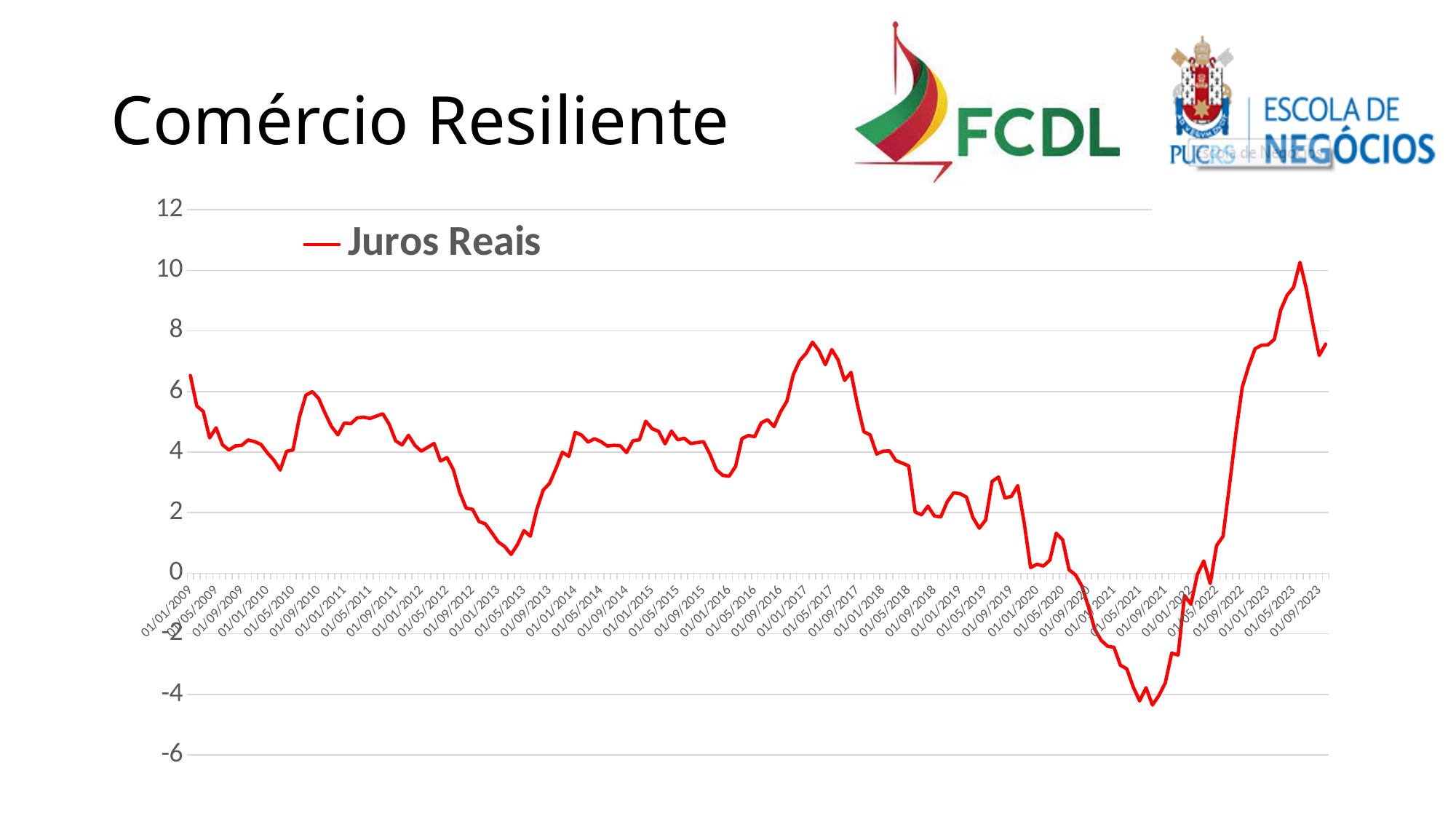
How many series does the chart legend list? 1 In which year does the Juros Reais line reach its highest value? 2023 Is the value for Juros Reais at 01/09/2021 greater or less than -2? less Is the value for Juros Reais at 01/05/2013 greater or less than 2? less What colour is the Juros Reais line? red What kind of chart is shown on the slide? line chart What is the name of the series shown in the chart legend? Juros Reais In which year does the Juros Reais line reach its lowest value? 2021 Which is larger, the Juros Reais value at 01/01/2009 or at 01/05/2013? 01/01/2009 Does the Juros Reais line rise or fall between 01/01/2021 and 01/05/2023? rise Is the value for Juros Reais at 01/01/2017 greater or less than 6? greater